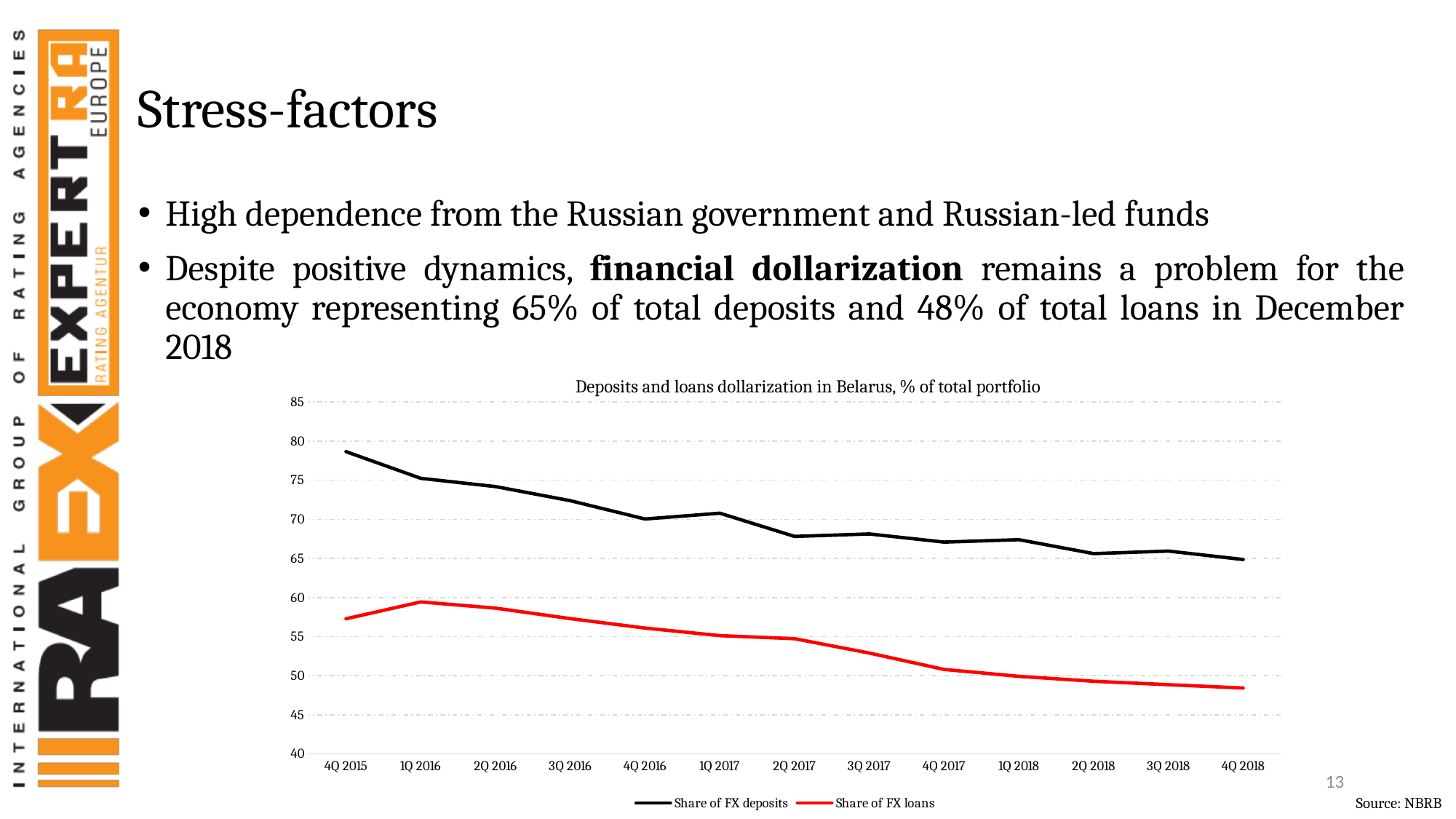
In 4Q 2018, which is larger: the Share of FX deposits or the Share of FX loans? Share of FX deposits What is the title of the chart? Deposits and loans dollarization in Belarus, % of total portfolio In which quarter is the Share of FX loans highest? 1Q 2016 Which series is drawn in red in the chart? Share of FX loans Is the Share of FX loans in 4Q 2018 greater or less than 50? less Is the Share of FX deposits in 4Q 2015 greater or less than 75? greater Is the Share of FX deposits in 2Q 2017 greater or less than 65? greater Does the Share of FX deposits rise or fall from 4Q 2015 to 4Q 2018? fall In which quarter is the Share of FX deposits highest? 4Q 2015 How many series does the legend of the chart list? 2 What kind of chart is shown on the slide? line chart How many quarters are plotted along the x axis of the chart? 13